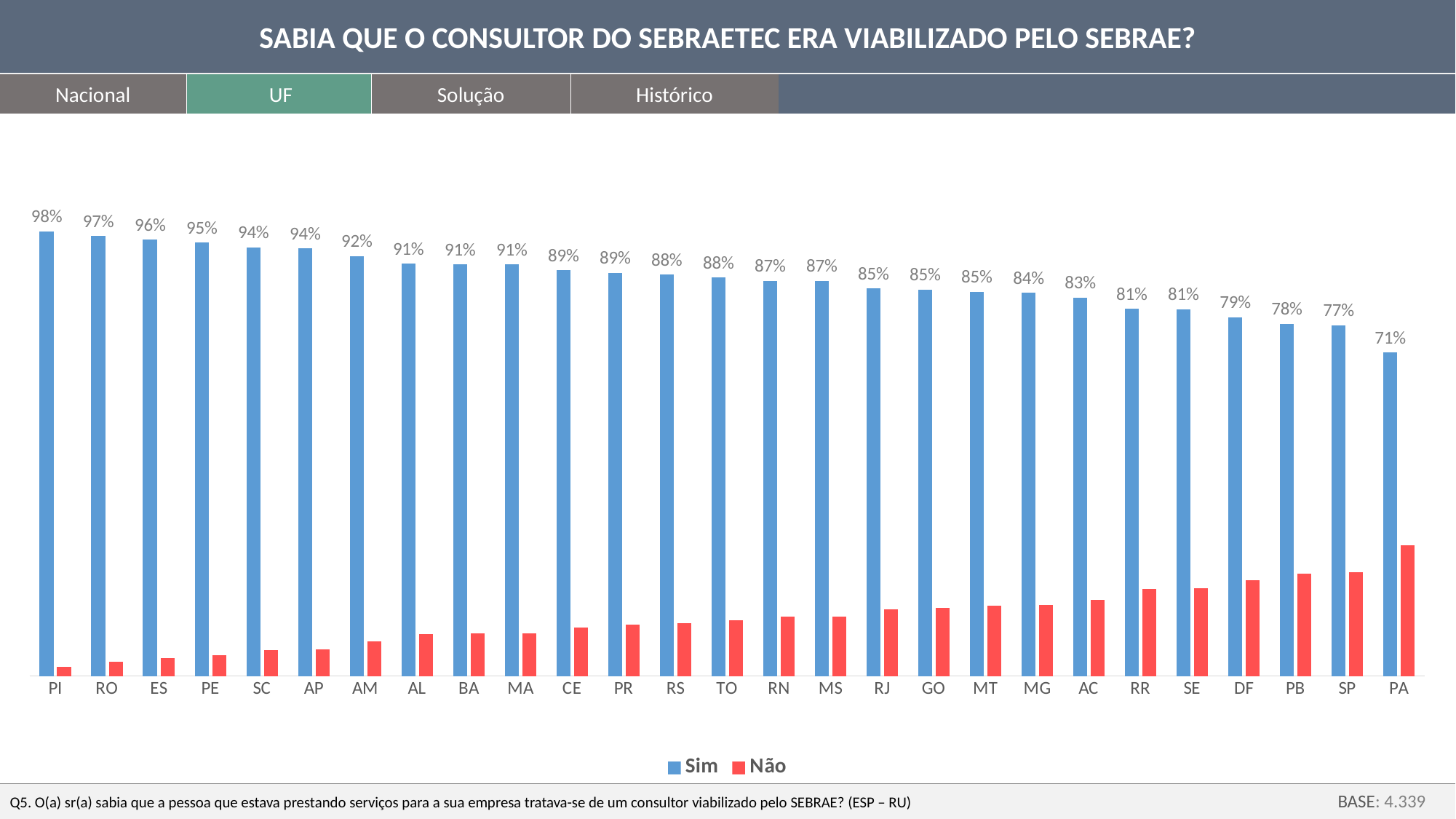
Which has a larger 'Sim' value, AM or DF? AM How many UF categories are shown on the x axis? 27 What is the 'Sim' value for SP? 77% Which has a larger 'Não' bar, PA or PI? PA What is the 'Sim' value for MG? 84% What is the difference between the 'Sim' values for PI and PA? 27% What is the 'Sim' value for PI? 98% Which UF has the lowest 'Sim' value? PA How many series does the legend list? 2 What kind of chart is shown on the slide? Bar chart Which UF has the highest 'Sim' value? PI What is the 'Sim' value for PA? 71%